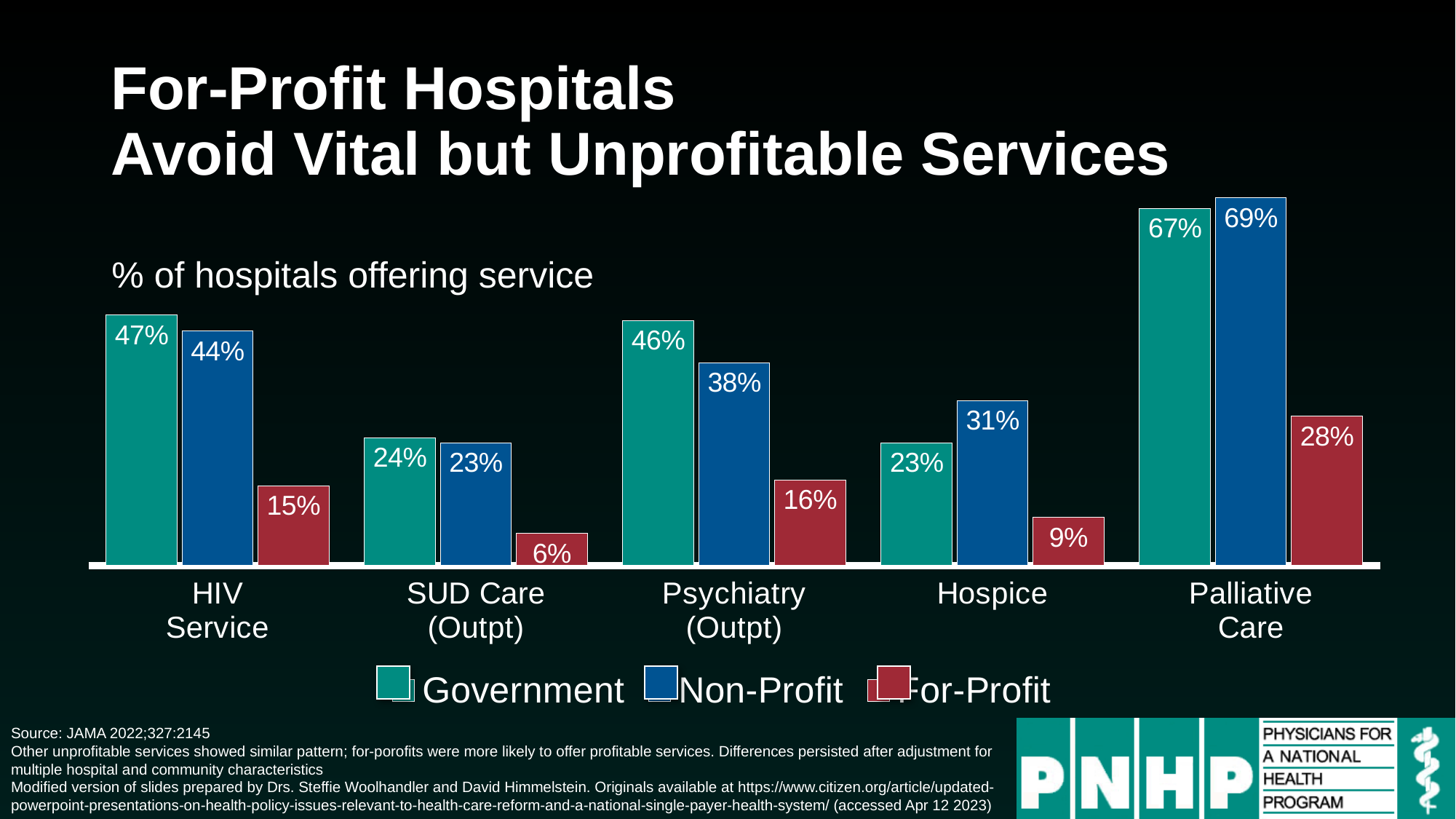
What kind of chart is shown on the slide? Bar chart Which colour represents For-Profit hospitals in the legend? Red What percentage of non-profit hospitals offer Psychiatry (Outpt)? 38% How many service categories are shown on the x axis? 5 What percentage of for-profit hospitals offer HIV Service? 15% What is the difference between the non-profit and for-profit values for Palliative Care? 41% Which is larger for Psychiatry (Outpt): the government value or the non-profit value? Government Which service has the highest value for non-profit hospitals? Palliative Care What is the difference between the government and for-profit values for Hospice? 14% What percentage of government hospitals offer Palliative Care? 67% How many series does the legend list? 3 Which service has the lowest value for for-profit hospitals? SUD Care (Outpt)